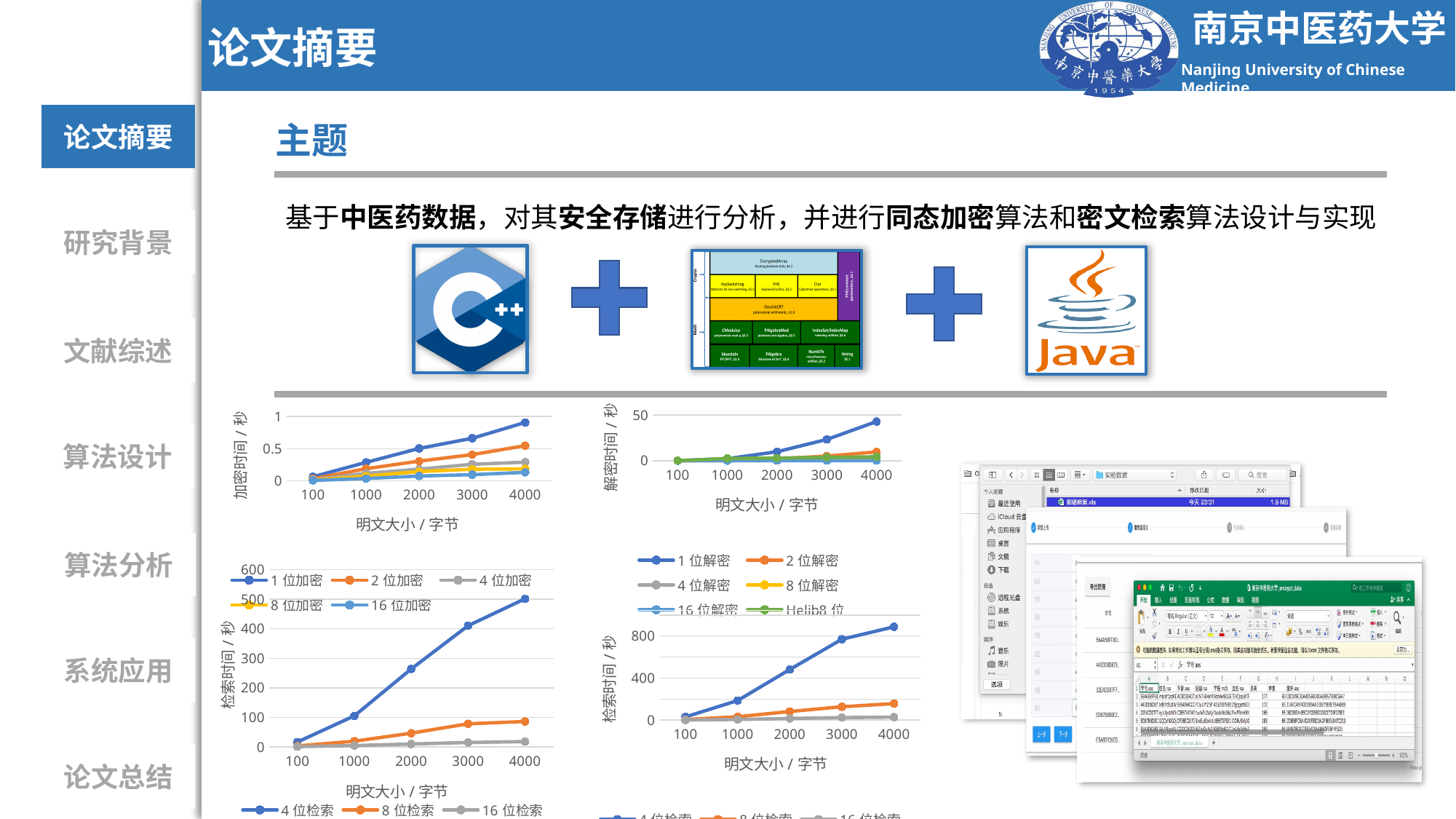
What kind of chart is the top-left chart (加密时间 / 秒)? line chart In the top-left chart (加密时间 / 秒), does the 1 位加密 series rise or fall as plaintext size increases? rise In the top-left chart (加密时间 / 秒), which is larger at 4000 bytes: 2 位加密 or 4 位加密? 2 位加密 In the bottom-left chart (检索时间 / 秒, y axis up to 600), is the value of 4 位检索 at 3000 bytes greater or less than 300? greater In the top-right chart (解密时间 / 秒), is the value of 1 位解密 at 4000 bytes greater or less than 50? less How many series does the legend of the top-right chart (解密时间 / 秒) list? 6 In the bottom-right chart (检索时间 / 秒, y axis up to 800), is the value of 4 位检索 at 4000 bytes greater or less than 800? greater How many series does the legend of the top-left chart (加密时间 / 秒) list? 5 In the bottom-left chart (检索时间 / 秒, y axis up to 600), which series has the highest value at 4000 bytes? 4 位检索 In the top-left chart (加密时间 / 秒), how many plaintext-size points are plotted along the x axis? 5 How many series does the legend of the bottom-left chart (检索时间 / 秒, y axis up to 600) list? 3